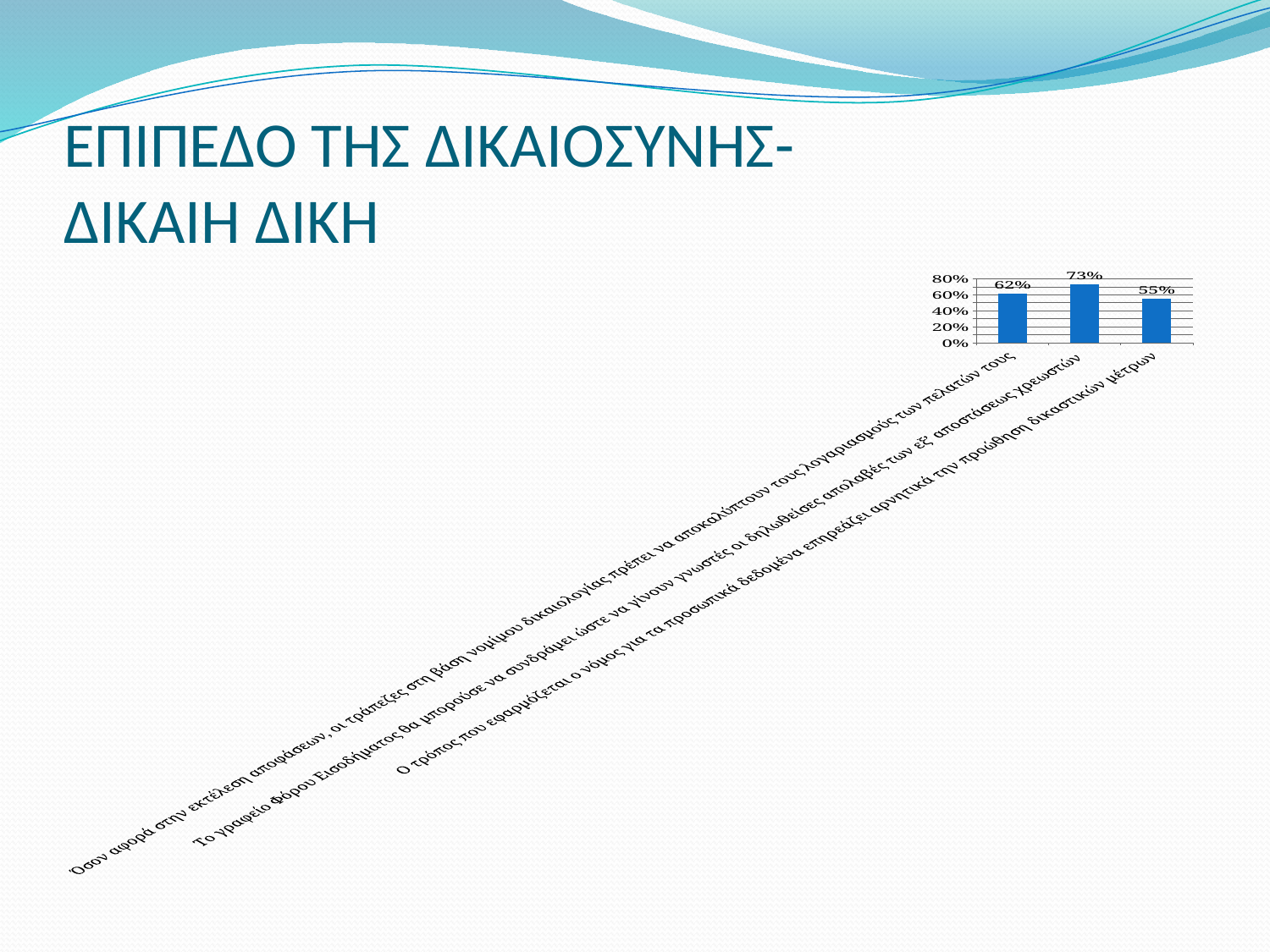
How many bars (categories) does the chart show? 3 What is the value of the second (middle) bar, for the statement about the Income Tax office ("Το γραφείο Φόρου Εισοδήματος...")? 73% What type of chart is shown on the slide? bar chart Is the value of the second (middle) bar greater or less than 60%? greater What is the value of the third (rightmost) bar, for the statement about the personal data law ("Ο τρόπος που εφαρμόζεται ο νόμος για τα προσωπικά δεδομένα...")? 55% What is the maximum value shown on the vertical axis of the chart? 80% What is the difference between the first bar (62%) and the second bar (73%)? 11% Which is larger, the value of the first bar or the value of the third bar? the first bar (62%) What is the value of the first (leftmost) bar, for the statement about banks revealing customer accounts ("Όσον αφορά στην εκτέλεση αποφάσεων...")? 62% Which bar has the highest value? the second (middle) bar, "Το γραφείο Φόρου Εισοδήματος..." (73%) Which bar has the lowest value? the third (rightmost) bar, "Ο τρόπος που εφαρμόζεται ο νόμος για τα προσωπικά δεδομένα..." (55%) What is the difference between the highest bar (73%) and the lowest bar (55%)? 18%